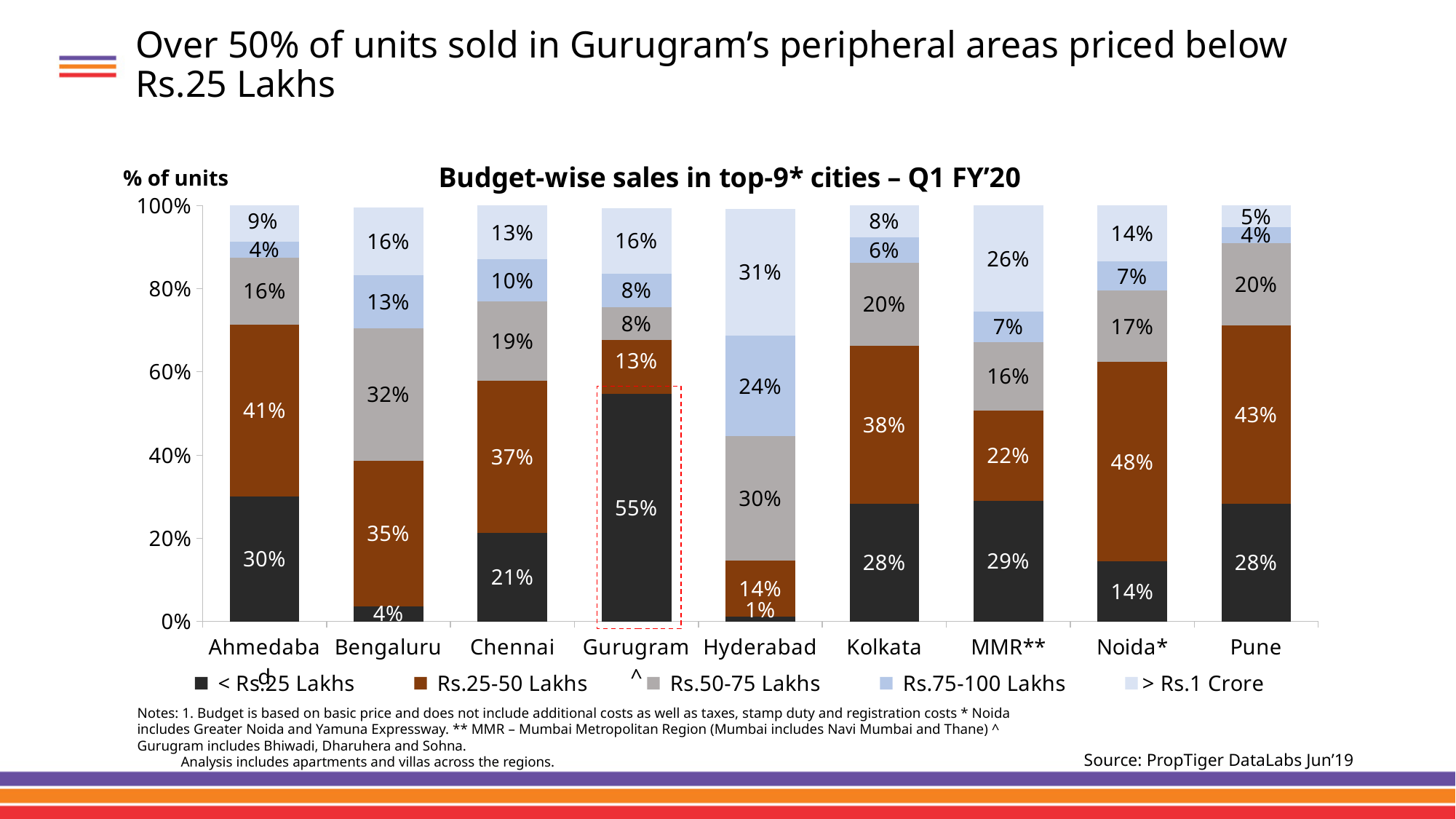
How many cities are shown on the x axis of the chart? 9 How many budget ranges does the legend list? 5 What is the difference between the Rs.25-50 Lakhs share in Noida and in Gurugram? 35% What percentage of units sold in Gurugram were priced below Rs.25 Lakhs? 55% What share of units sold in Hyderabad were priced above Rs.1 Crore? 31% What is the title of the chart? Budget-wise sales in top-9* cities – Q1 FY'20 What type of chart is used to show budget-wise sales? Stacked bar chart Which city has the lowest share of units sold below Rs.25 Lakhs? Hyderabad Which city has a larger share of units in the Rs.50-75 Lakhs range, Bengaluru or Chennai? Bengaluru Which city has the highest share of units sold above Rs.1 Crore? Hyderabad What percentage of units sold in Noida were in the Rs.25-50 Lakhs budget range? 48% Which city has the highest share of units sold below Rs.25 Lakhs? Gurugram